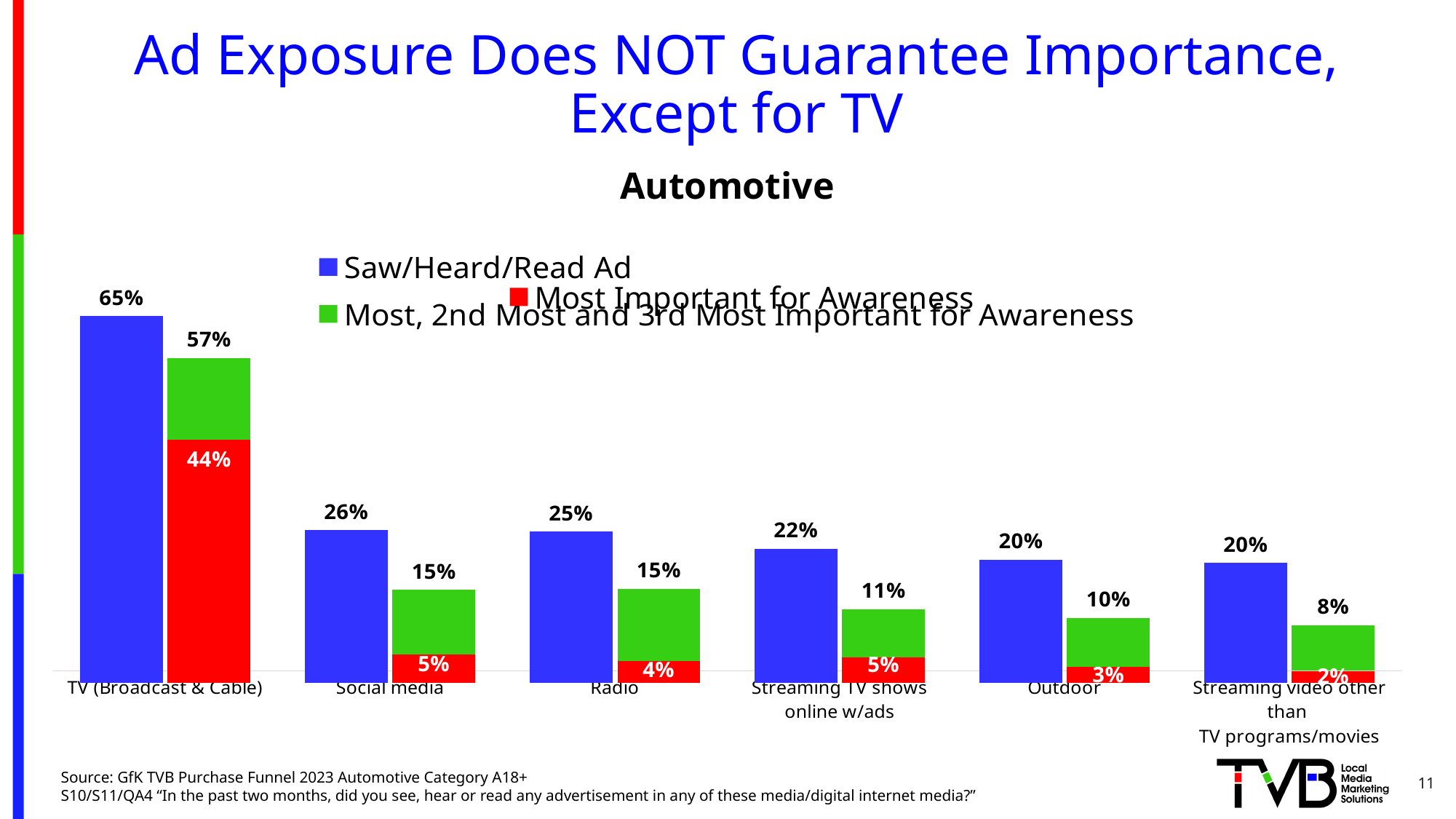
Which category has the lowest Most Important for Awareness value? Streaming video other than TV programs/movies What kind of chart is shown on the slide? Bar chart Which colour represents the Most Important for Awareness series? Red What is the Saw/Heard/Read Ad value for TV (Broadcast & Cable)? 65% What is the Most, 2nd Most and 3rd Most Important for Awareness value for Outdoor? 10% How many series does the legend list? 3 Which category has the highest Saw/Heard/Read Ad value? TV (Broadcast & Cable) Which is larger: the Saw/Heard/Read Ad value for Social media or for Streaming TV shows online w/ads? Social media What is the difference between the Saw/Heard/Read Ad value and the Most Important for Awareness value for TV (Broadcast & Cable)? 21% Do the Saw/Heard/Read Ad values rise or fall from left to right across the categories? Fall What is the Most Important for Awareness value for Radio? 4% How many media categories are shown on the x axis? 6